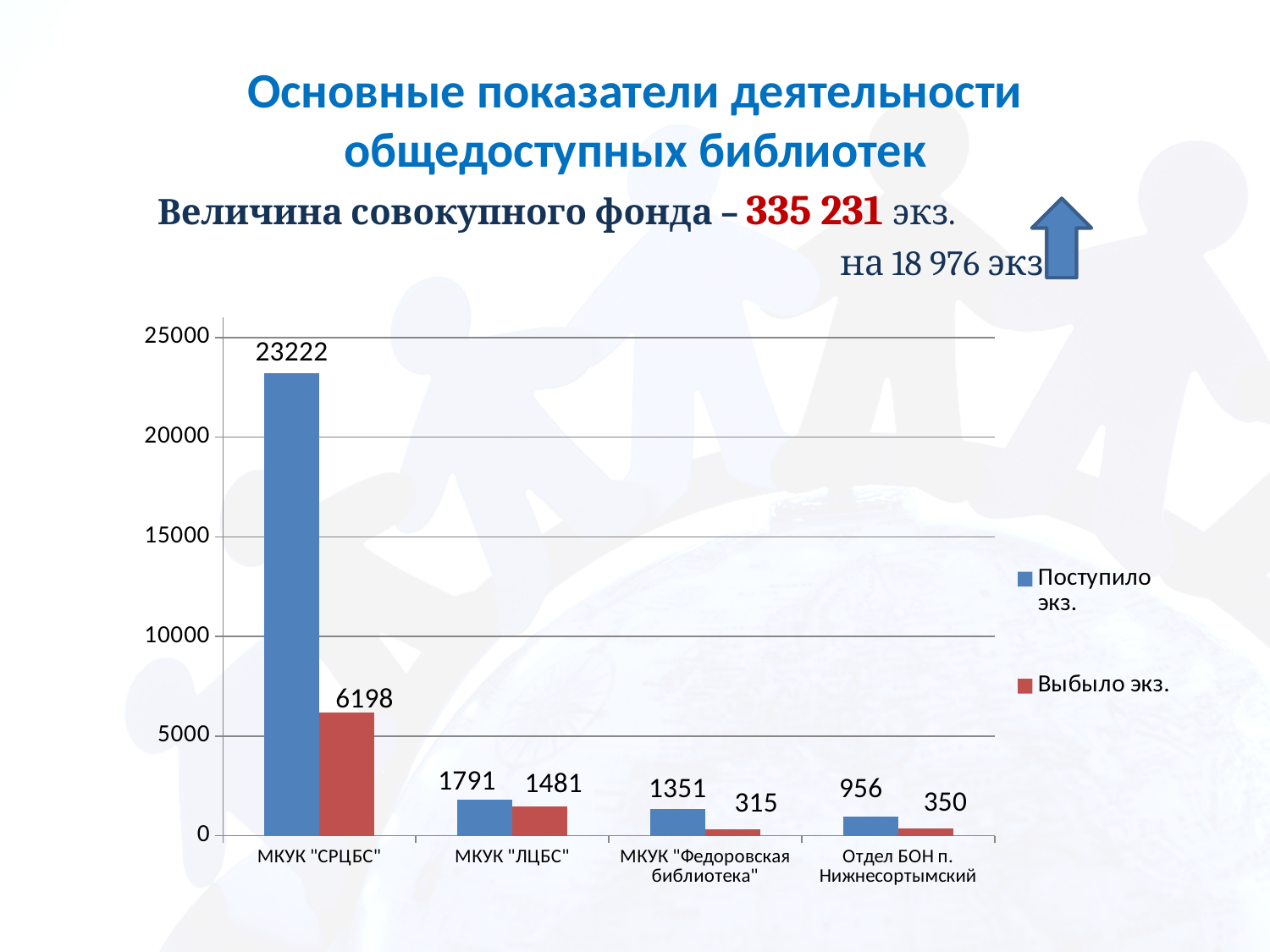
Is the value of "Выбыло экз." for МКУК "СРЦБС" greater or less than 5000? greater What is the value of "Выбыло экз." for МКУК "Федоровская библиотека"? 315 What is the value of "Выбыло экз." for МКУК "ЛЦБС"? 1481 How many series does the legend list? 2 What is the value of "Поступило экз." for МКУК "СРЦБС"? 23222 What is the value of "Поступило экз." for Отдел БОН п. Нижнесортымский? 956 Which is larger: "Выбыло экз." for МКУК "ЛЦБС" or "Поступило экз." for МКУК "Федоровская библиотека"? "Выбыло экз." for МКУК "ЛЦБС" Which category has the highest value for "Поступило экз."? МКУК "СРЦБС" What is the difference between "Поступило экз." and "Выбыло экз." for МКУК "СРЦБС"? 17024 How many categories are shown on the x axis? 4 Which category has the lowest value for "Выбыло экз."? МКУК "Федоровская библиотека" What kind of chart is shown on the slide? bar chart